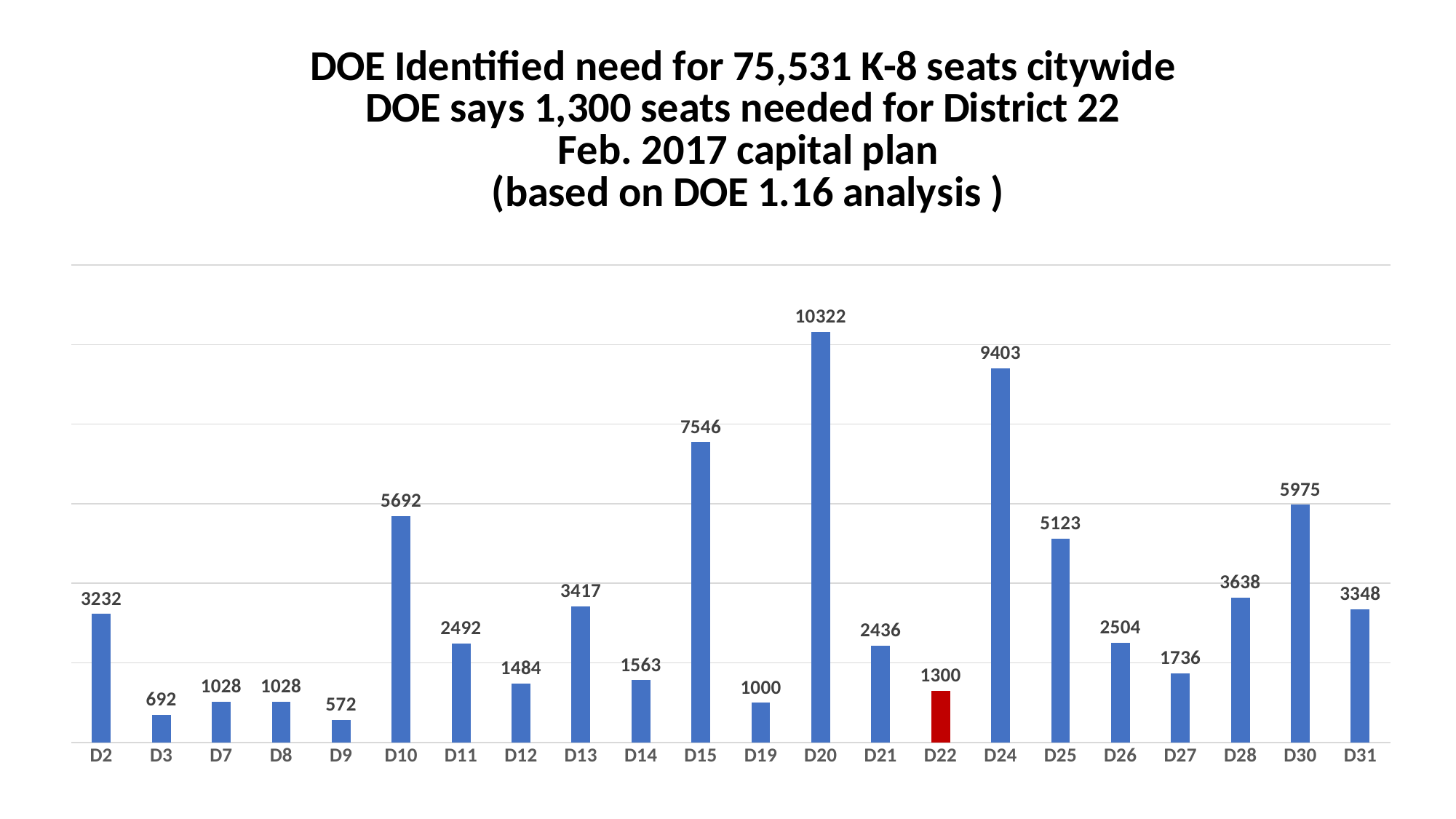
Which is larger, the value for D10 or the value for D30? D30 What value is shown for D22? 1300 What is the difference between the values for D20 and D24? 919 What is the difference between the values for D22 and D19? 300 What value is shown for D15? 7546 Which is larger, the value for D13 or the value for D28? D28 How many districts are shown on the x axis? 22 What kind of chart is this? bar chart Which bar is coloured red instead of blue? D22 Which district has the lowest value? D9 Which district has the highest value? D20 What value is shown for D9? 572